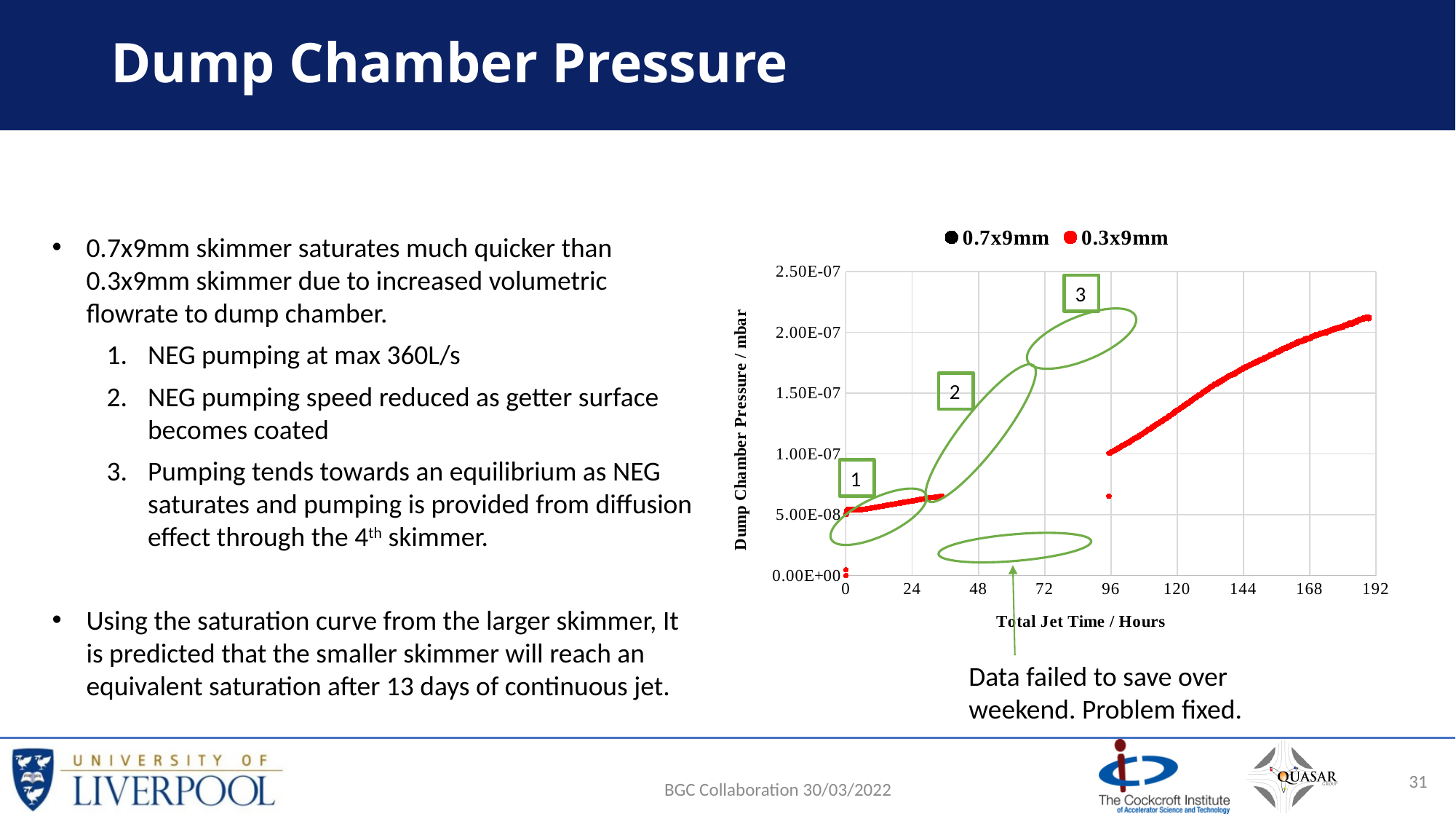
How many series does the chart legend list? 2 How many tick labels are shown on the x axis of the chart? 9 Is the 0.3x9mm pressure at 144 hours greater or less than 1.50E-07? greater Is the 0.3x9mm pressure at 120 hours greater or less than 1.50E-07? less Is the 0.3x9mm pressure at 192 hours greater or less than 2.00E-07? greater What is the maximum value shown on the y axis of the chart? 2.50E-07 Does the 0.3x9mm pressure rise or fall as total jet time increases? rise What is the title of the y axis of the chart? Dump Chamber Pressure / mbar What is the title of the x axis of the chart? Total Jet Time / Hours What kind of chart is shown on the slide? scatter chart